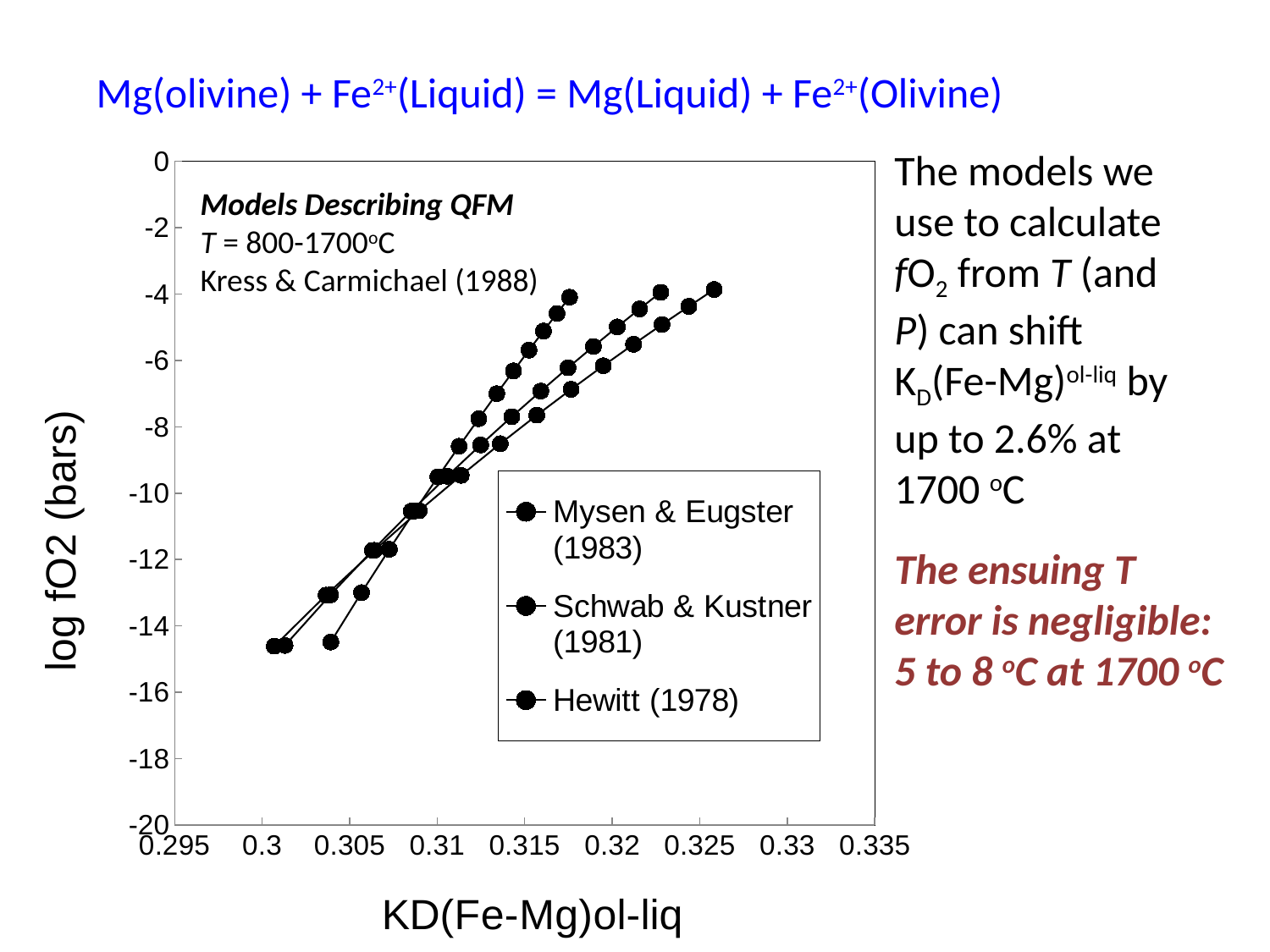
What kind of chart is shown on the slide? Line chart with markers (scatter plot) What is the label of the y axis of the chart? log fO2 (bars) How many series does the chart legend list? 3 Is the lowest plotted log fO2 value greater or less than -16? greater Which three studies are listed in the chart legend? Mysen & Eugster (1983), Schwab & Kustner (1981), Hewitt (1978) Do the plotted log fO2 values rise or fall as KD(Fe-Mg)ol-liq increases along the x axis? Rise Is the highest plotted log fO2 value greater or less than -2? less Are all plotted points at KD(Fe-Mg)ol-liq values greater or less than 0.33? less